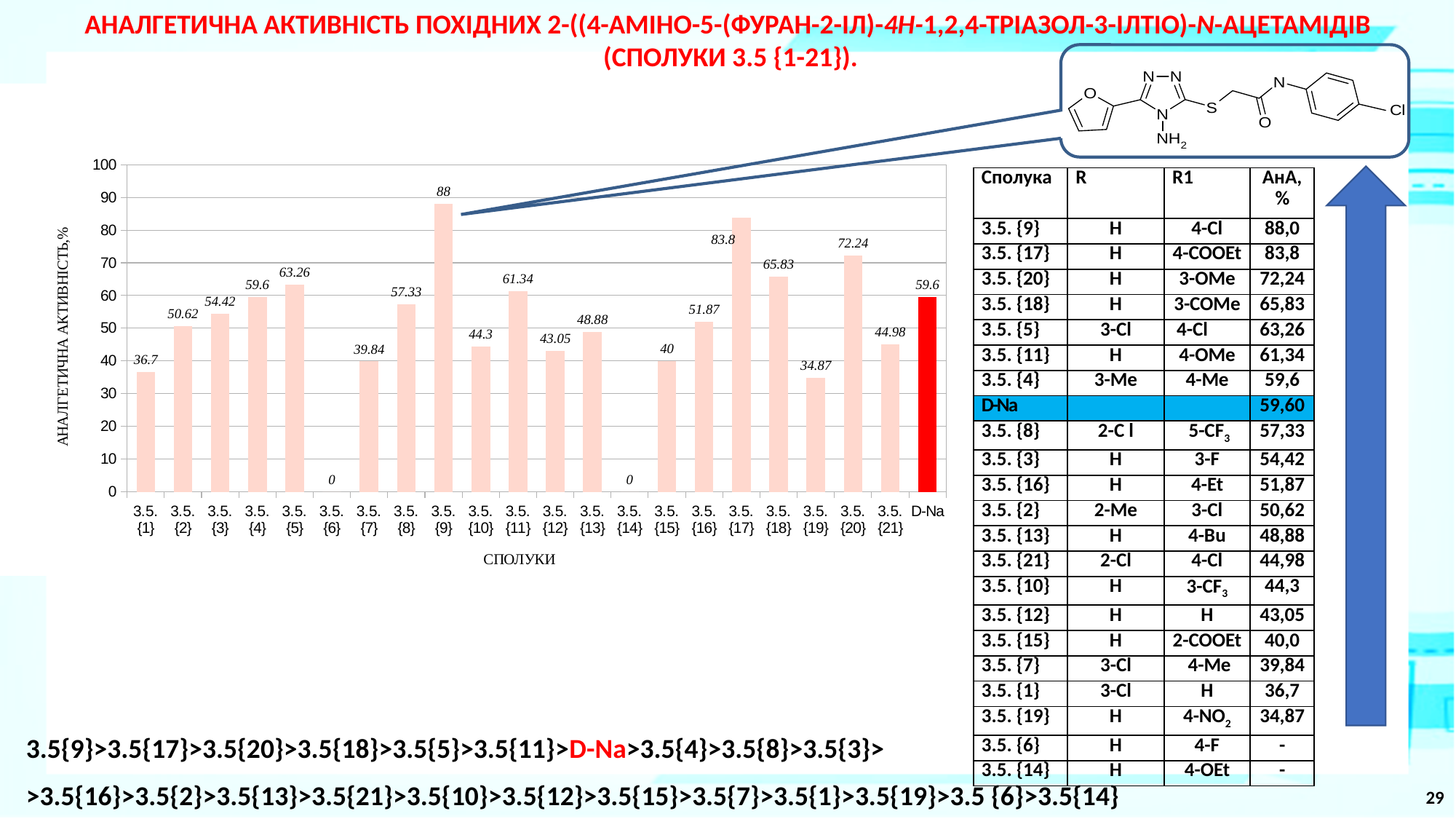
What is the value for 3.5.{9} in the bar chart? 88 What kind of chart is shown on the slide? bar chart How many categories are shown on the x axis of the bar chart? 22 What is the value for D-Na in the bar chart? 59.6 What is the value for 3.5.{19} in the bar chart? 34.87 Which is larger, the value for 3.5.{20} or the value for 3.5.{18}? 3.5.{20} Which category has the highest value in the bar chart? 3.5.{9} What is the label of the y axis of the chart? АНАЛГЕТИЧНА АКТИВНІСТЬ,% What is the value for 3.5.{17} in the bar chart? 83.8 Is the value for 3.5.{5} greater or less than 60? greater Which category has the lowest non-zero value in the bar chart? 3.5.{19} What is the difference between the values for 3.5.{9} and 3.5.{17}? 4.2